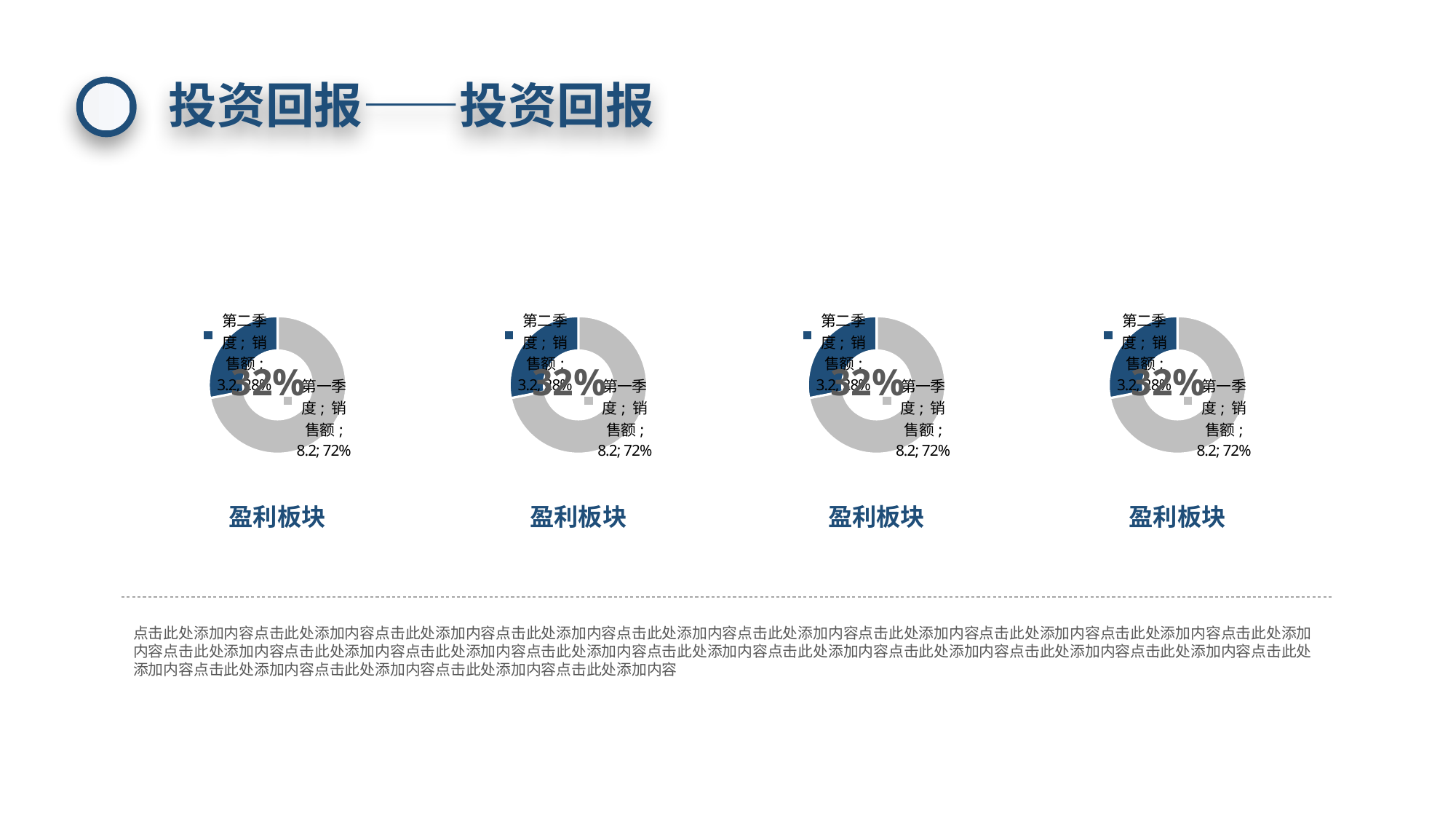
In the leftmost chart, what is the 销售额 value for 第一季度? 8.2 In the rightmost chart, which quarter has the larger slice? 第一季度 What kind of chart is the leftmost chart on the slide? doughnut chart How many doughnut charts are shown on the slide? 4 In the leftmost chart, how many slices does the doughnut have? 2 In the third chart from the left, what colour is the 第二季度 slice? dark blue In the second chart from the left, what is the 销售额 value for 第二季度? 3.2 What caption appears below each of the four doughnut charts? 盈利板块 In the rightmost chart, which quarter has the smaller slice? 第二季度 In the third chart from the left, what share of the doughnut does 第一季度 take? 72% In the leftmost chart, is the 销售额 for 第一季度 larger or smaller than that for 第二季度? larger In the second chart from the left, what is the difference in 销售额 between 第一季度 and 第二季度? 5